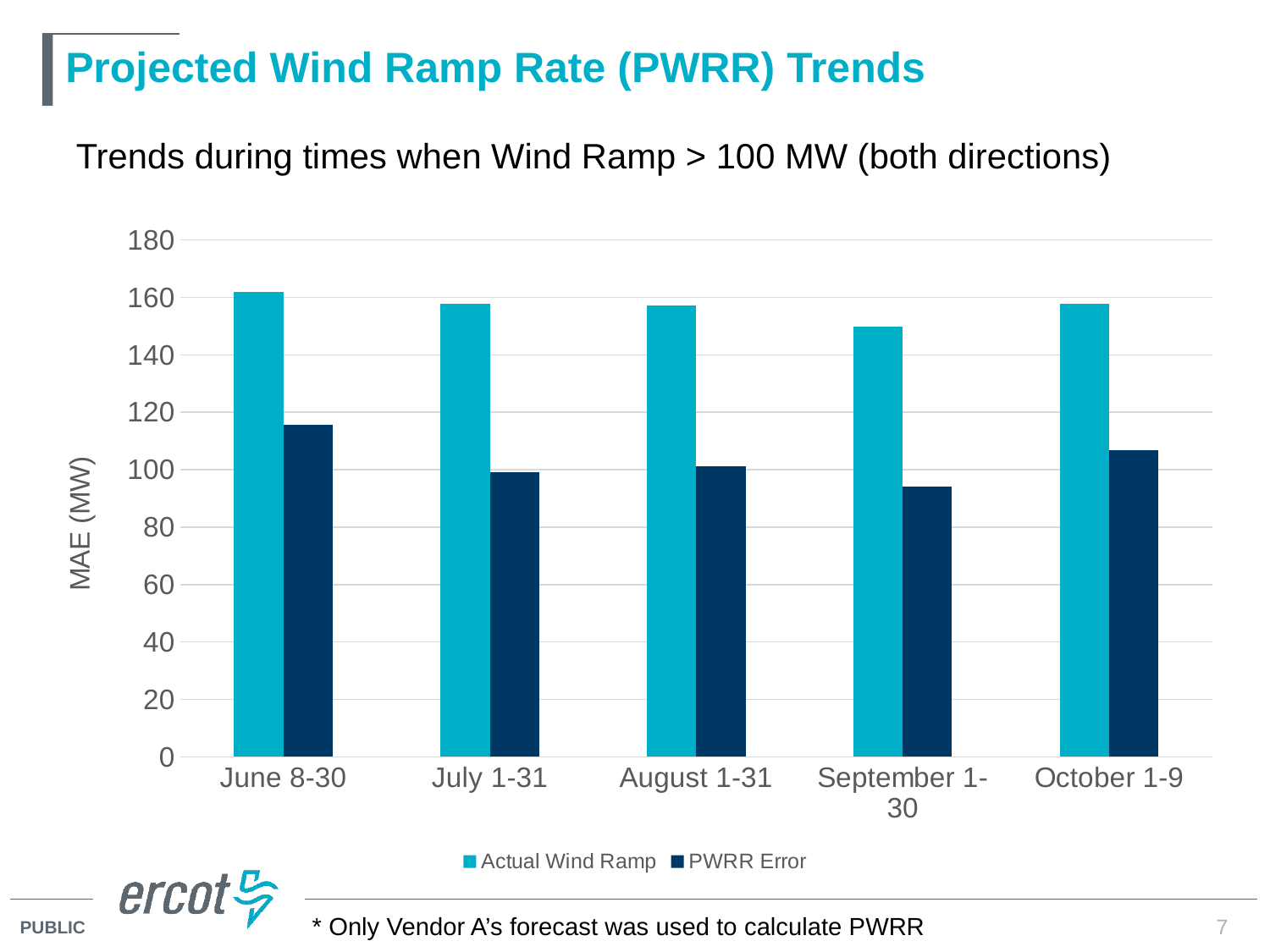
How many time periods are shown on the x axis? 5 Is the Actual Wind Ramp value for September 1-30 greater or less than 160? less Which is larger, the PWRR Error for June 8-30 or for October 1-9? June 8-30 Which period has the highest PWRR Error value? June 8-30 How many series does the legend list? 2 Which period has the lowest PWRR Error value? September 1-30 Which period has the lowest Actual Wind Ramp value? September 1-30 What kind of chart is shown on the slide? bar chart Which period has the highest Actual Wind Ramp value? June 8-30 Is the PWRR Error value for June 8-30 greater or less than 100? greater Is the PWRR Error value for September 1-30 greater or less than 100? less What is the label on the y axis of the chart? MAE (MW)